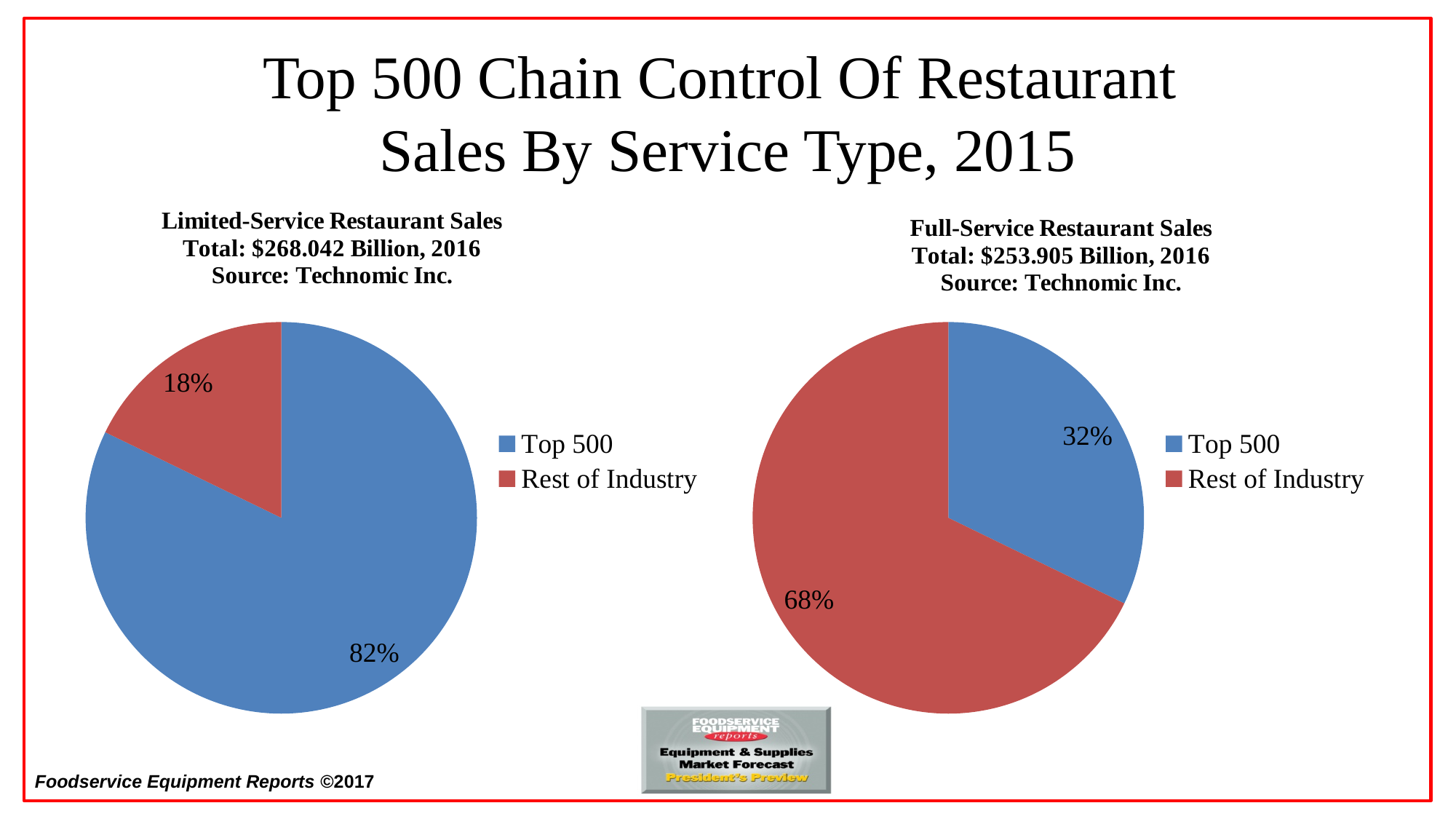
What type of chart is used for the Full-Service Restaurant Sales chart? Pie chart In the Full-Service Restaurant Sales chart, which slice is the smallest? Top 500 In the Full-Service Restaurant Sales chart, what share of sales is held by the Rest of Industry? 68% Which chart shows a larger Top 500 share, Limited-Service Restaurant Sales or Full-Service Restaurant Sales? Limited-Service Restaurant Sales In the Limited-Service Restaurant Sales chart, what share of sales is held by the Rest of Industry? 18% What total sales figure is given in the title of the Full-Service Restaurant Sales chart? $253.905 Billion, 2016 In the Limited-Service Restaurant Sales chart, what share of sales is held by the Top 500? 82% In the Limited-Service Restaurant Sales chart, what is the difference between the Top 500 share and the Rest of Industry share? 64% In the Limited-Service Restaurant Sales chart, which slice is the largest? Top 500 In the Full-Service Restaurant Sales chart, what share of sales is held by the Top 500? 32% In the Full-Service Restaurant Sales chart, what is the difference between the Rest of Industry share and the Top 500 share? 36% How many slices does the Limited-Service Restaurant Sales pie chart have? 2